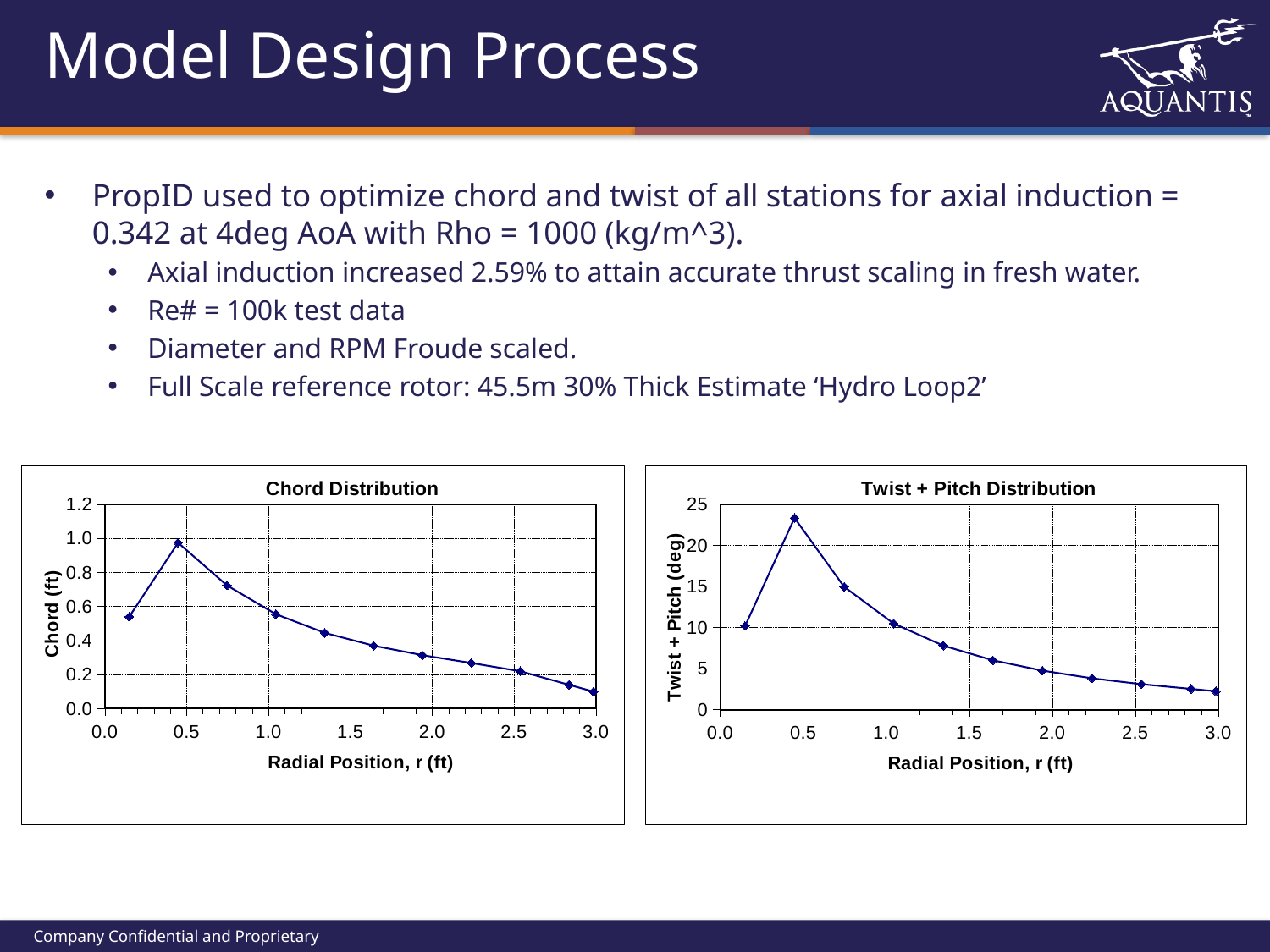
On the Twist + Pitch Distribution chart, do the values rise or fall between radial positions 1.0 and 3.0? fall What is the x-axis label of the Chord Distribution chart? Radial Position, r (ft) What is the y-axis label of the Twist + Pitch Distribution chart? Twist + Pitch (deg) How many data points are plotted on the Twist + Pitch Distribution chart? 11 On the Twist + Pitch Distribution chart, is the value at radial position 3.0 greater or less than 5? less On the Twist + Pitch Distribution chart, is the peak value greater or less than 20? greater What kind of chart is the Twist + Pitch Distribution chart? line chart On the Chord Distribution chart, is the peak chord value greater or less than 0.8? greater On the Chord Distribution chart, do the values rise or fall along the x axis after the peak near 0.5 ft? fall What kind of chart is the Chord Distribution chart? line chart How many data points are plotted on the Chord Distribution chart? 11